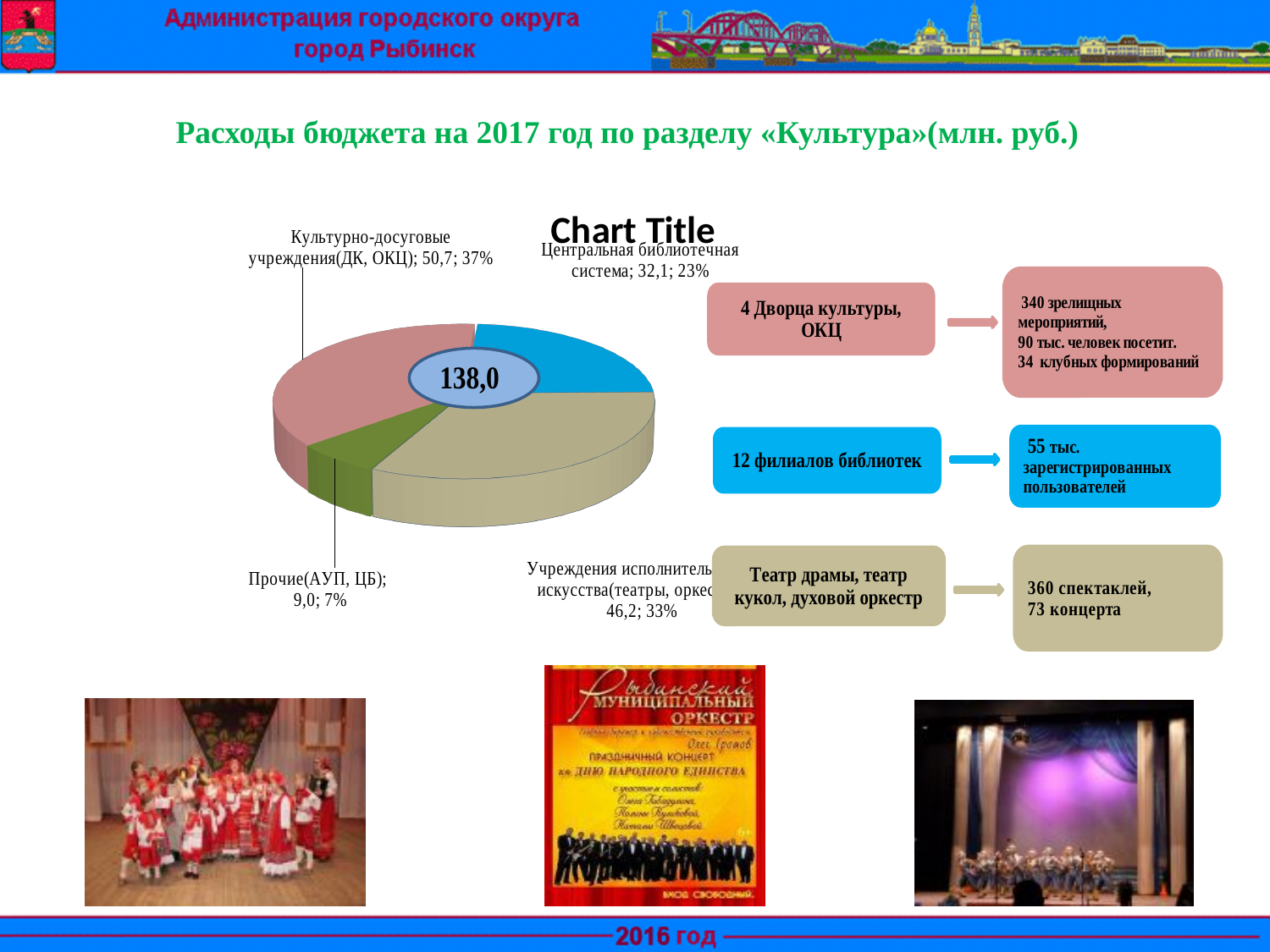
Which category has the largest slice in the pie chart? Культурно-досуговые учреждения (ДК, ОКЦ) What is the title shown above the pie chart? Chart Title What number is printed in the centre of the pie chart? 138,0 What kind of chart is shown on the slide? pie chart Which is larger: the value for Центральная библиотечная система or the value for Прочие (АУП, ЦБ)? Центральная библиотечная система What is the difference between the values for Культурно-досуговые учреждения (ДК, ОКЦ) and Центральная библиотечная система? 18,6 Which category has the smallest slice in the pie chart? Прочие (АУП, ЦБ) What share of the pie does Прочие (АУП, ЦБ) have? 7% What value is shown for Культурно-досуговые учреждения (ДК, ОКЦ) in the pie chart? 50,7 What share of the pie does Центральная библиотечная система have? 23% What value is shown for Прочие (АУП, ЦБ) in the pie chart? 9,0 How many slices does the pie chart have? 4